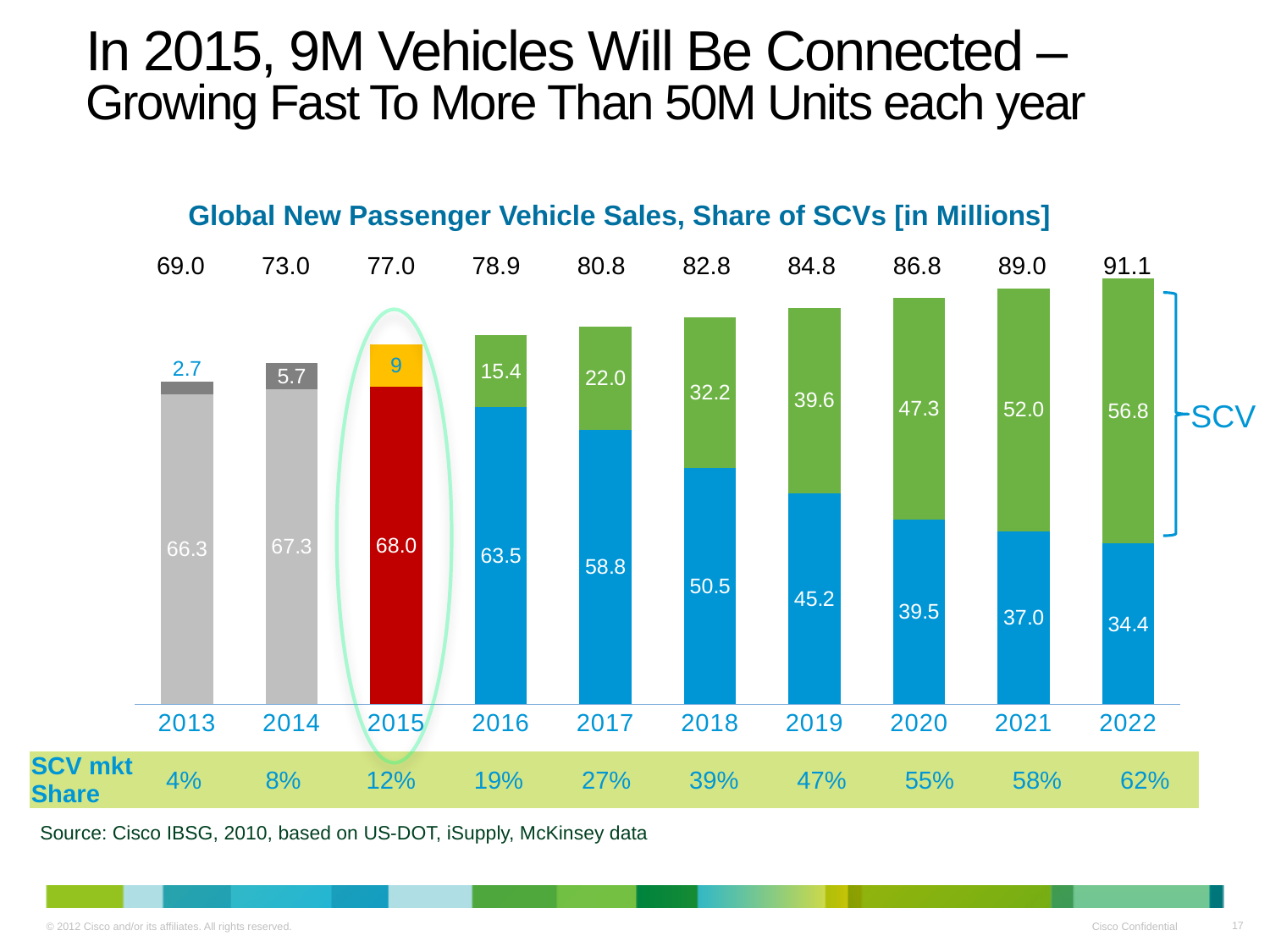
What is the total value printed above the bar for 2022? 91.1 What kind of chart is shown on the slide? Stacked bar chart How many years are shown on the x axis? 10 Which year has the lowest SCV value? 2013 What is the difference between the SCV values for 2022 and 2021? 4.8 Do the SCV values rise or fall from 2013 to 2022? Rise What is the SCV value for 2015? 9 What is the title of the chart? Global New Passenger Vehicle Sales, Share of SCVs [in Millions] Which year has the highest total new passenger vehicle sales? 2022 What is the value of the lower (non-SCV) segment for 2018? 50.5 What is the SCV market share shown for 2019? 47% Which is larger, the SCV value for 2017 or the SCV value for 2016? 2017